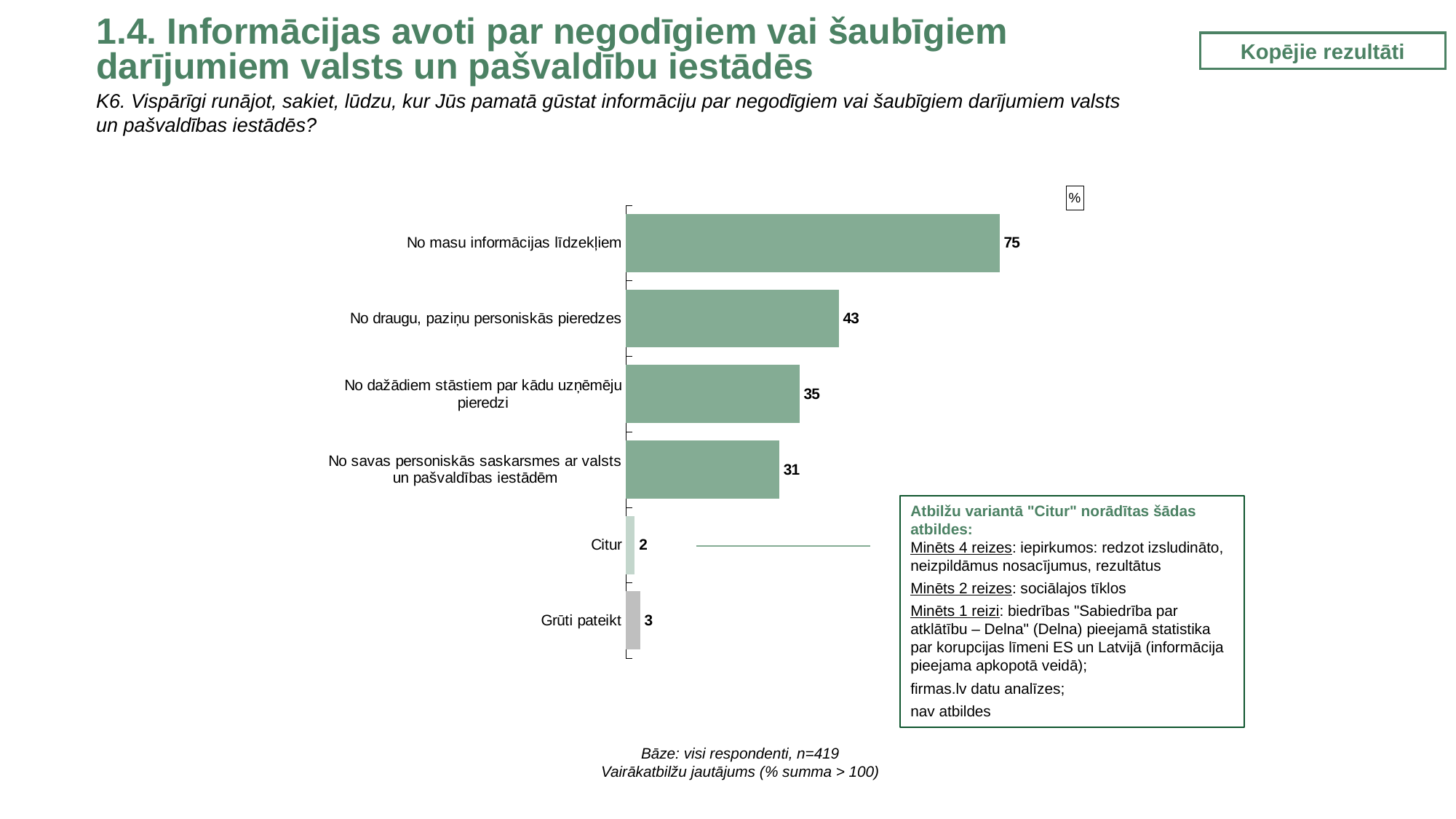
What kind of chart is shown on the slide? Bar chart How many categories are shown in the chart? 6 What is the difference between the values for "No dažādiem stāstiem par kādu uzņēmēju pieredzi" and "No savas personiskās saskarsmes ar valsts un pašvaldības iestādēm"? 4 Which category has the highest value? No masu informācijas līdzekļiem What is the base (n) of respondents stated below the chart? n=419 What is the value for "Grūti pateikt"? 3 What is the value for "No masu informācijas līdzekļiem"? 75 Which category has the lowest value? Citur What is the value for "No draugu, paziņu personiskās pieredzes"? 43 What is the value for "No savas personiskās saskarsmes ar valsts un pašvaldības iestādēm"? 31 What is the difference between the values for "No masu informācijas līdzekļiem" and "No draugu, paziņu personiskās pieredzes"? 32 Which is larger: the value for "No draugu, paziņu personiskās pieredzes" or for "No dažādiem stāstiem par kādu uzņēmēju pieredzi"? No draugu, paziņu personiskās pieredzes